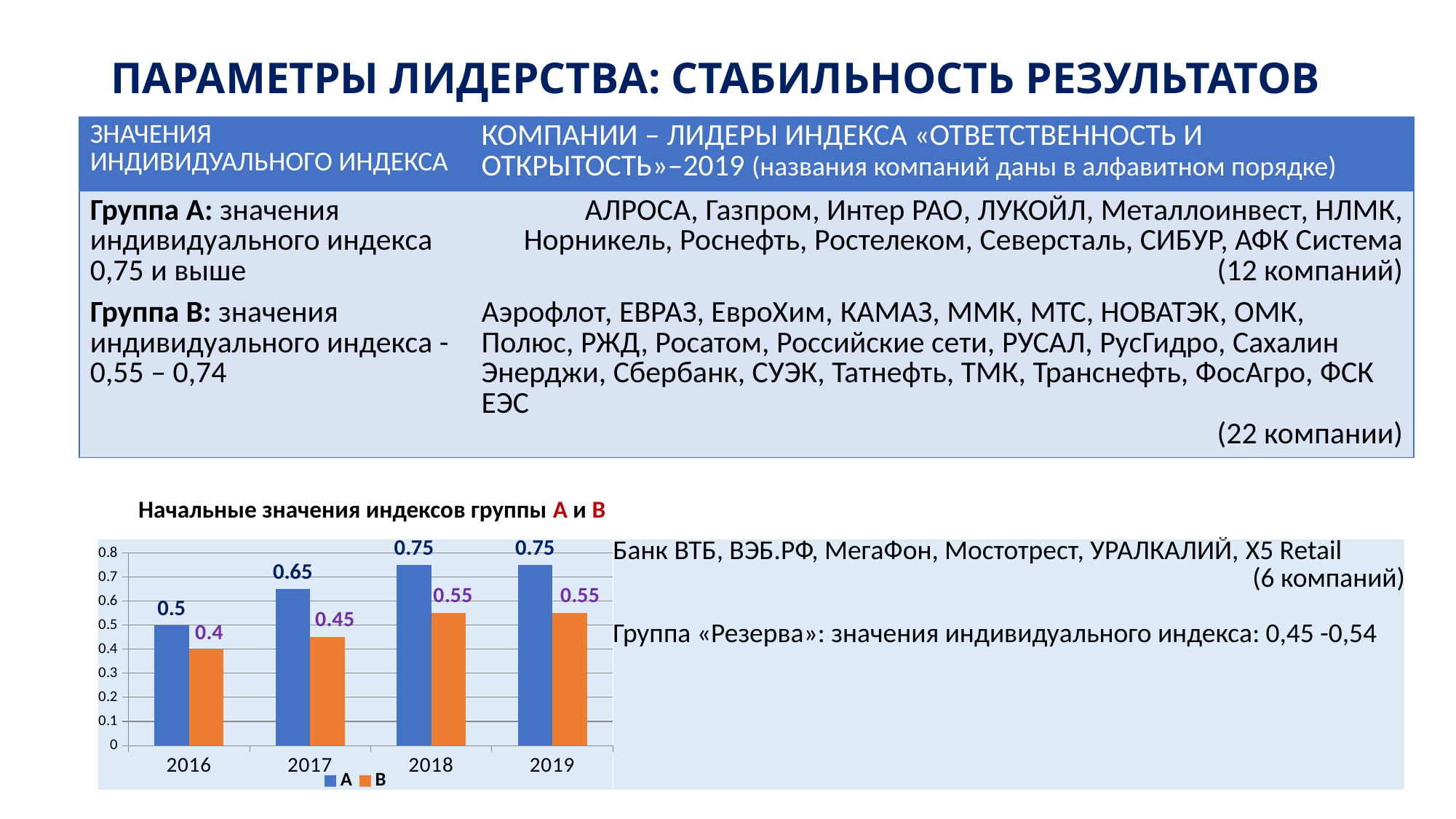
In which year is the value for series B the lowest? 2016 What is the difference between series A and series B in 2017? 0.2 What is the difference between the series A values in 2018 and 2016? 0.25 What type of chart is shown on the slide? Bar chart What is the value for series A in 2016? 0.5 How many series does the chart legend list? 2 What is the value for series A in 2018? 0.75 Which is larger in 2019, the value for series A or series B? A Do the values for series B rise or fall from 2016 to 2019? Rise What is the value for series B in 2019? 0.55 What is the value for series B in 2017? 0.45 How many years are shown on the x axis of the chart? 4